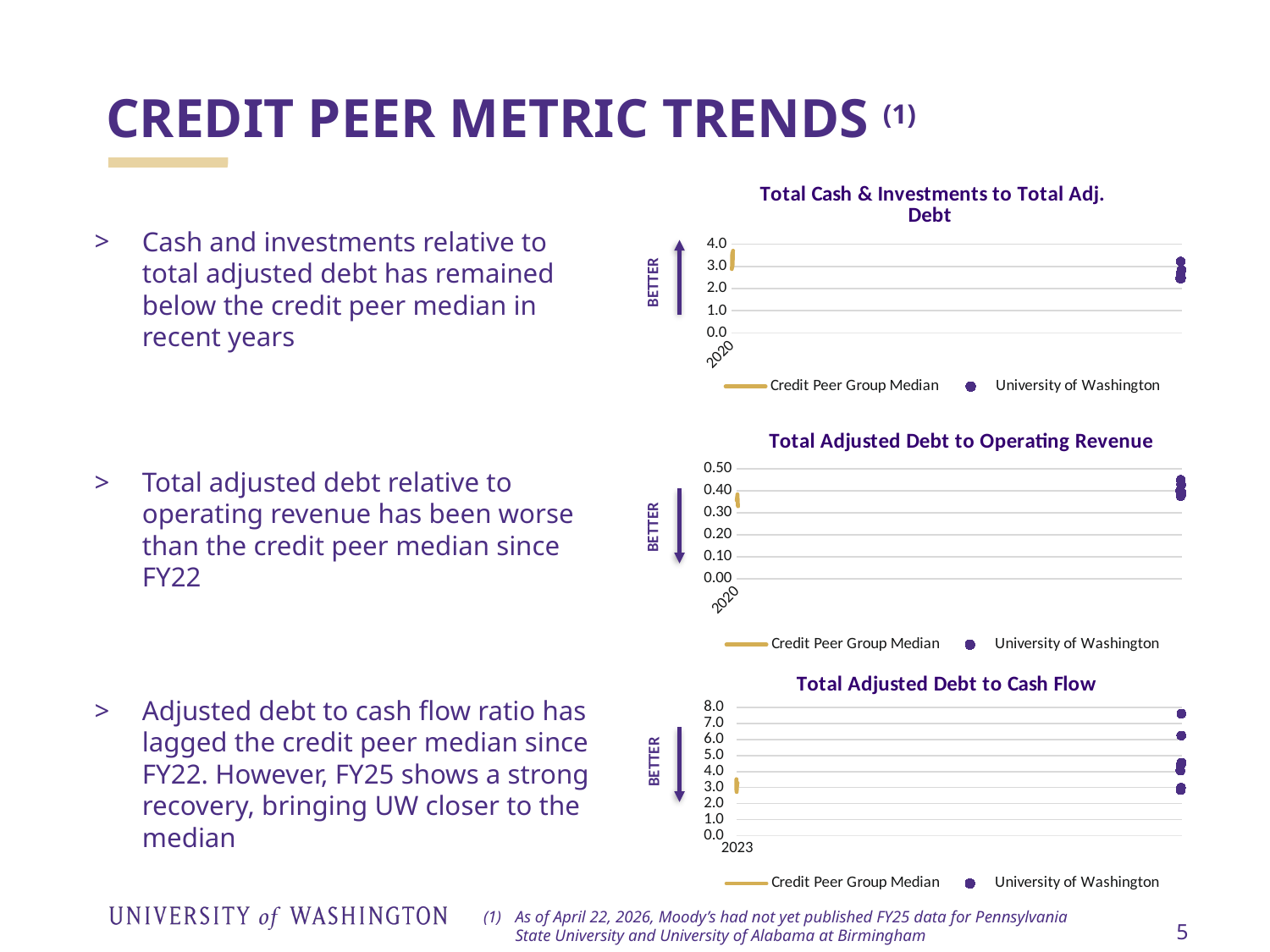
On the 'Total Cash & Investments to Total Adj. Debt' chart, are the University of Washington values greater or less than 4.0? less On the 'Total Adjusted Debt to Cash Flow' chart, what are the two legend entries? Credit Peer Group Median and University of Washington How many charts are shown on the slide? 3 On the 'Total Cash & Investments to Total Adj. Debt' chart, is the Credit Peer Group Median value greater or less than 2.0? greater On the 'Total Adjusted Debt to Cash Flow' chart, is the Credit Peer Group Median value greater or less than 5.0? less On the 'Total Adjusted Debt to Cash Flow' chart, what is the highest value shown on the y axis? 8.0 On the 'Total Cash & Investments to Total Adj. Debt' chart, how many series does the legend list? 2 What kind of chart is the 'Total Adjusted Debt to Operating Revenue' chart? line chart On the 'Total Adjusted Debt to Cash Flow' chart, how many series does the legend list? 2